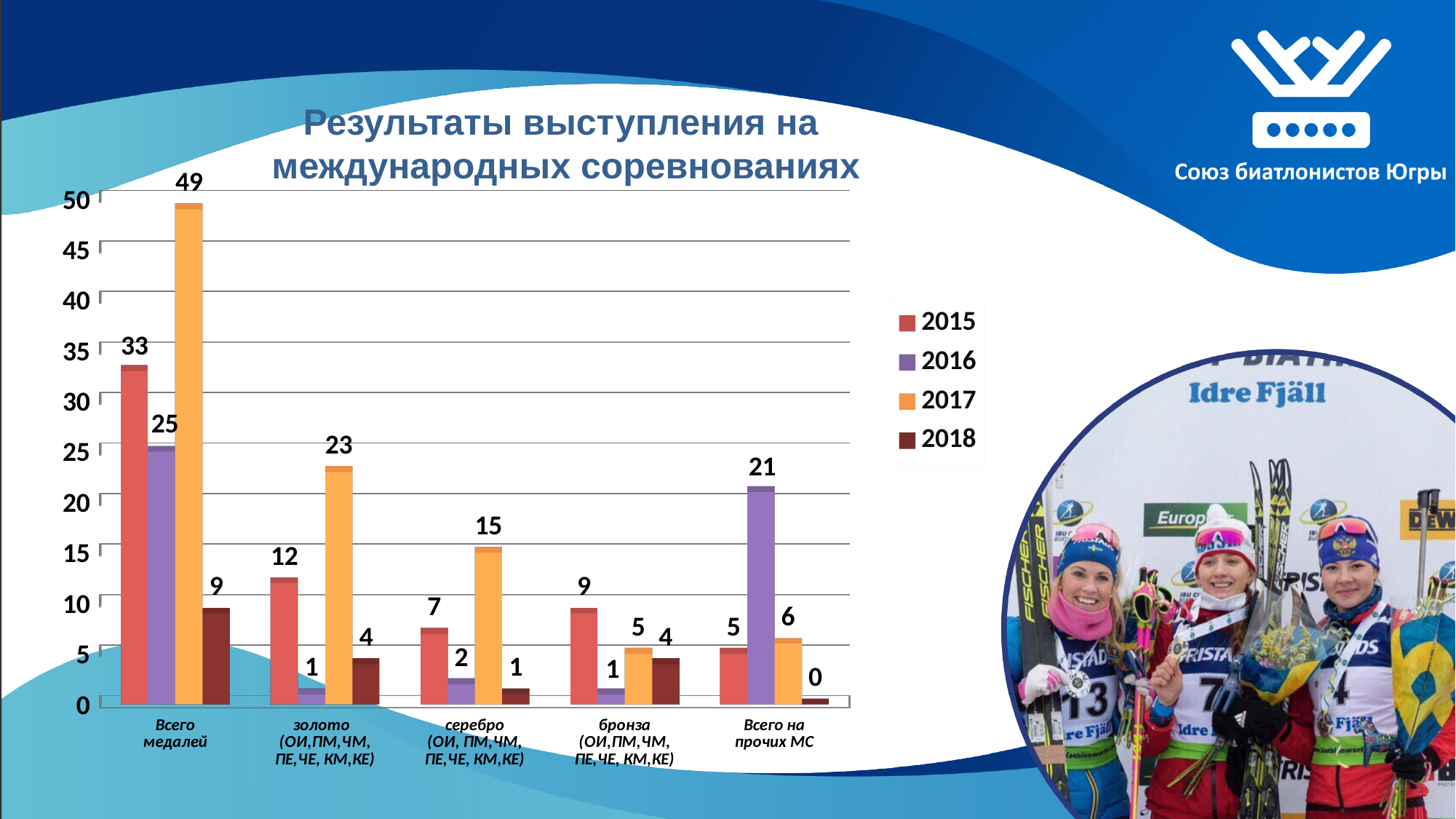
What is the difference between the 2017 and 2015 values in the "Всего медалей" category? 16 In the "бронза" category, which is larger: the value for 2015 or the value for 2017? 2015 What is the title of the chart? Результаты выступления на международных соревнованиях What kind of chart is shown on the slide? bar chart How many categories are shown on the x axis of the chart? 5 What is the value for 2017 in the "Всего медалей" category? 49 What is the value for 2016 in the "Всего на прочих МС" category? 21 How many series does the legend list? 4 Which year has the lowest value in the "Всего на прочих МС" category? 2018 What is the value for 2018 in the "золото" category? 4 Which year has the highest value in the "серебро" category? 2017 Which colour represents the 2017 series in the legend? orange